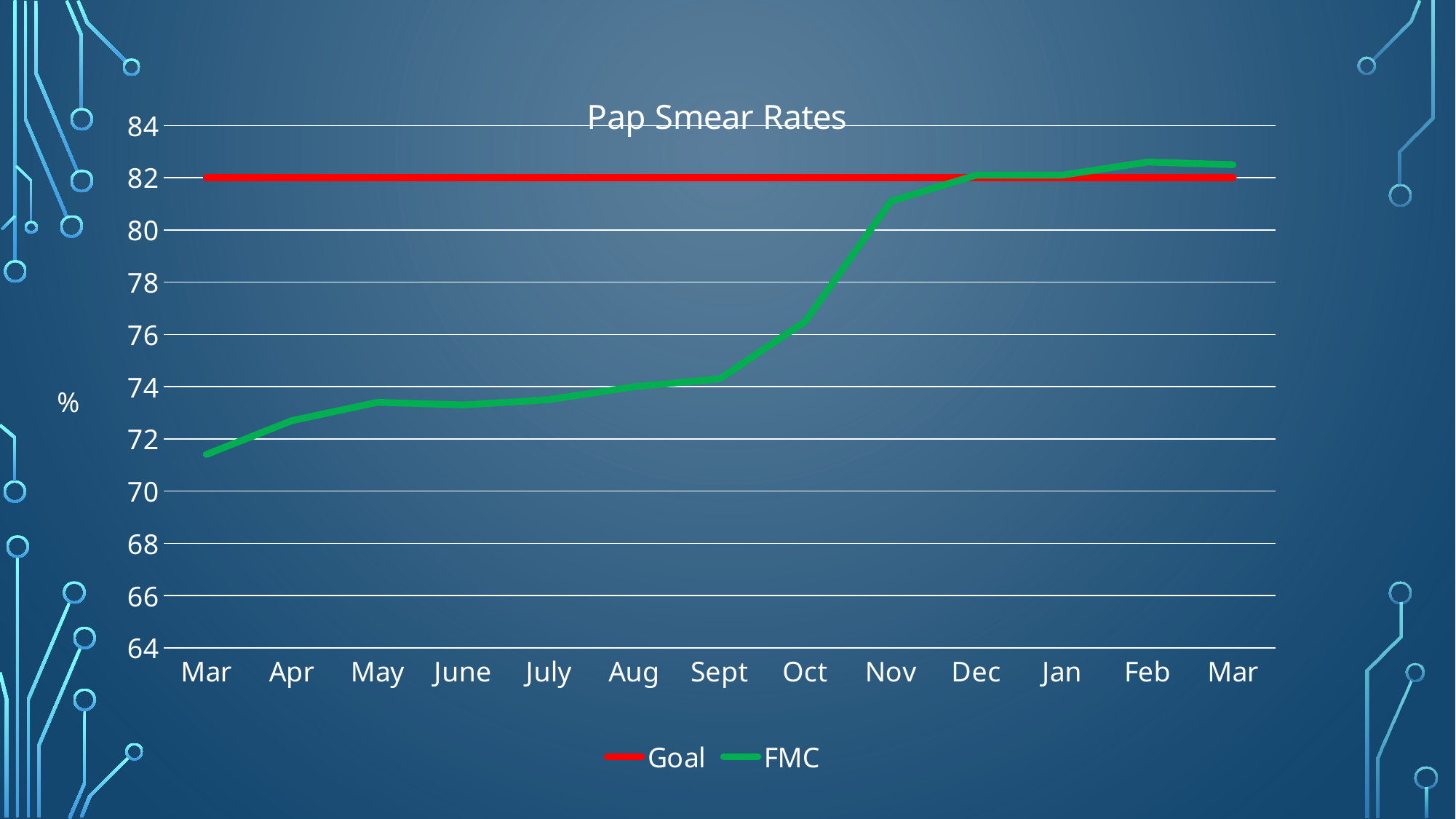
In Sept, which series has the larger value, Goal or FMC? Goal Is the FMC value for Nov greater or less than 80? greater Is the FMC value for June greater or less than 74? less How many series does the legend list? 2 How many months are plotted along the x axis? 13 In which month is the FMC value lowest? Mar (first) What is the value of the Goal series? 82 What is the title of the chart? Pap Smear Rates Is the FMC value for the first Mar greater or less than 72? less Does the FMC series generally rise or fall from the first Mar to the last Mar? rise What kind of chart is shown on the slide? line chart